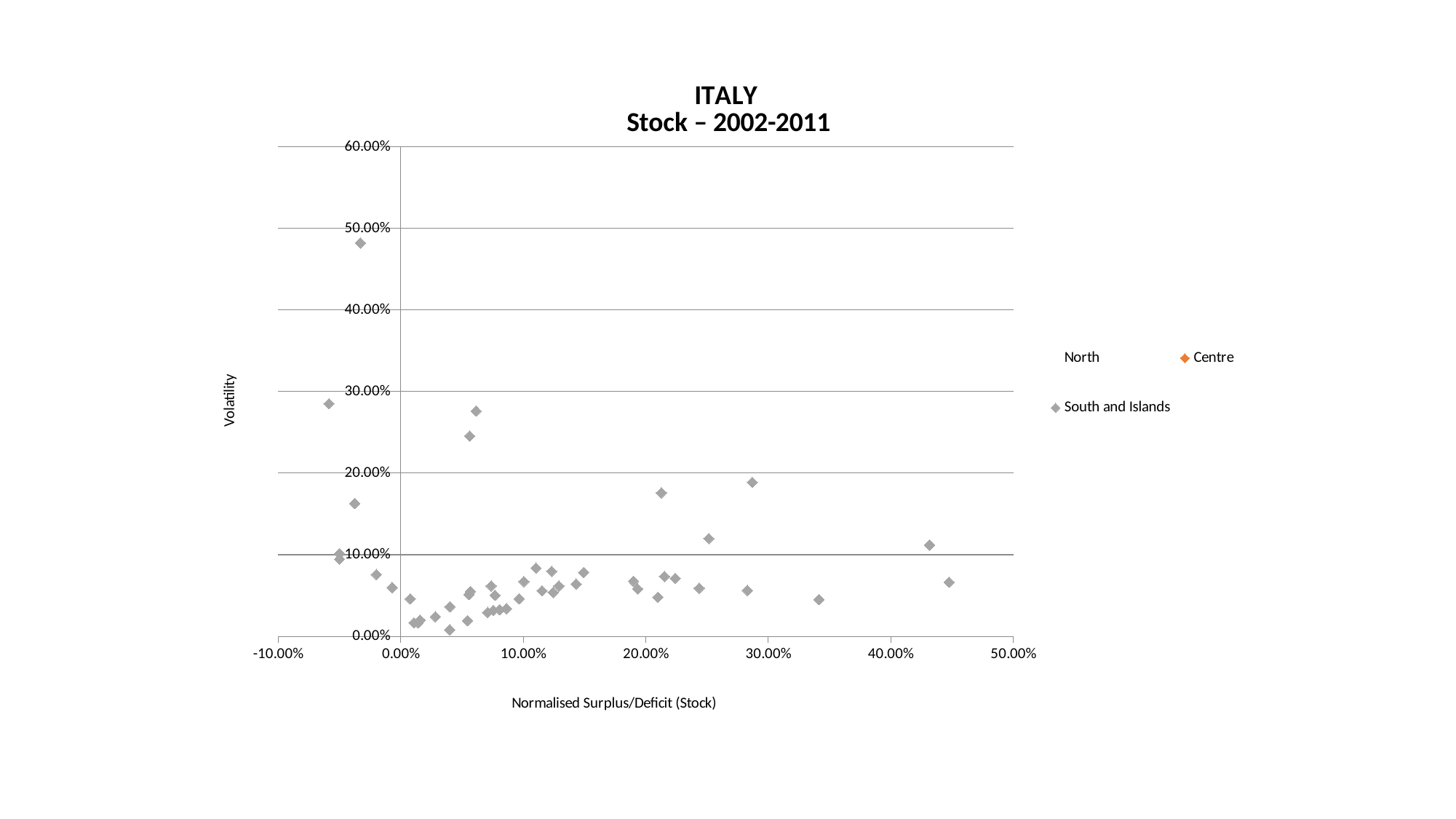
Is the highest volatility value plotted greater or less than 40.00%? greater How many series does the legend list? 3 What is the title of the chart? ITALY Stock – 2002-2011 What kind of chart is shown on the slide? scatter chart Is the volatility of the point plotted near 34% on the x axis greater or less than 10.00%? less Is the highest volatility value plotted greater or less than 50.00%? less Which series do the grey diamond markers represent according to the legend? South and Islands